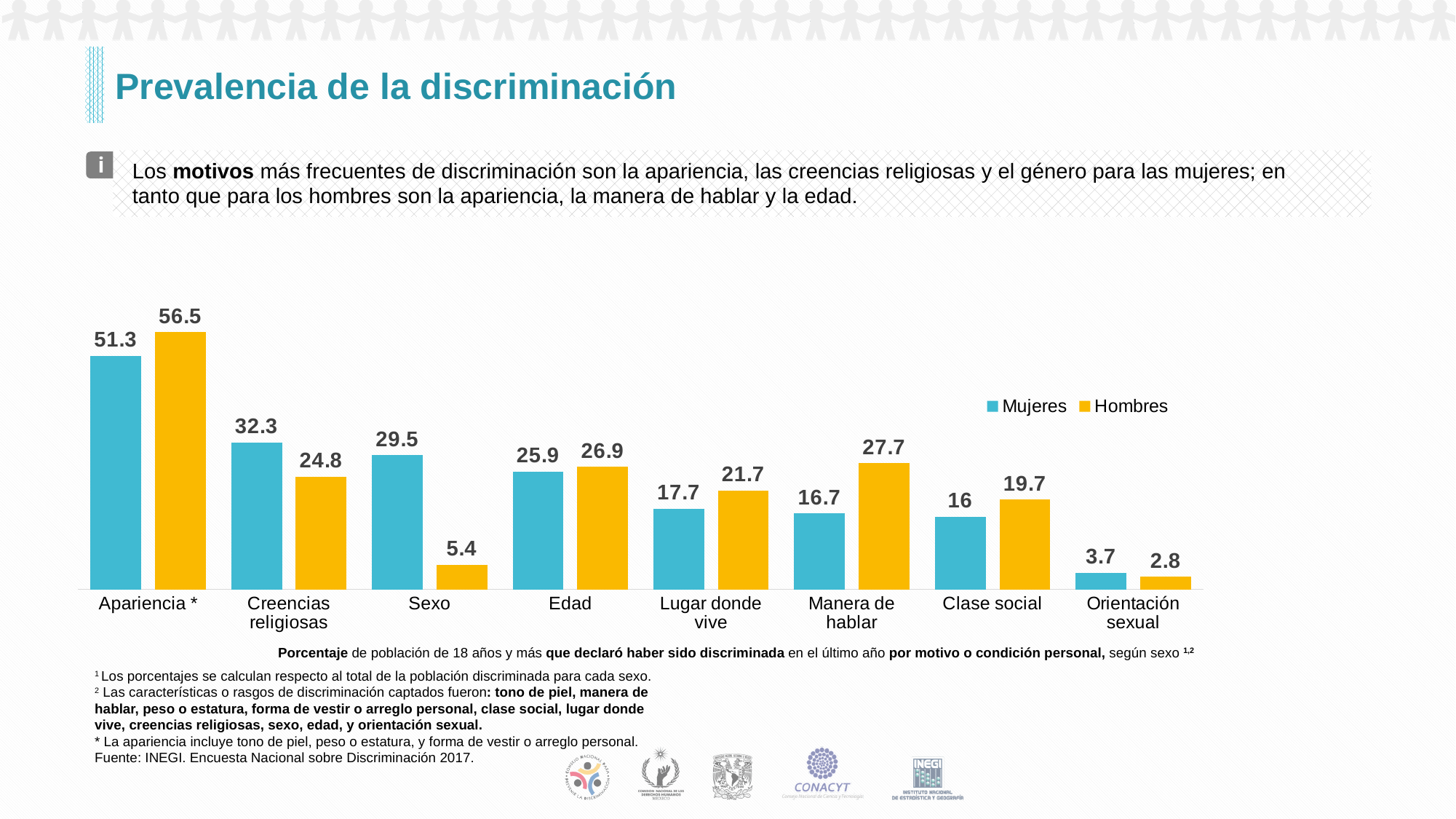
What is the value for Mujeres in the Apariencia * category? 51.3 What type of chart is shown on the slide? Bar chart What is the value for Hombres in the Sexo category? 5.4 Which category has the lowest value for Mujeres? Orientación sexual How many series does the legend list? 2 How many categories are shown on the x axis of the chart? 8 Which is larger for Clase social: the Mujeres value or the Hombres value? Hombres What is the difference between the Mujeres and Hombres values for Sexo? 24.1 What is the difference between the Hombres and Mujeres values for Apariencia *? 5.2 What is the value for Hombres in the Manera de hablar category? 27.7 Which category has the highest value for Hombres? Apariencia * Which is larger for Creencias religiosas: the Mujeres value or the Hombres value? Mujeres